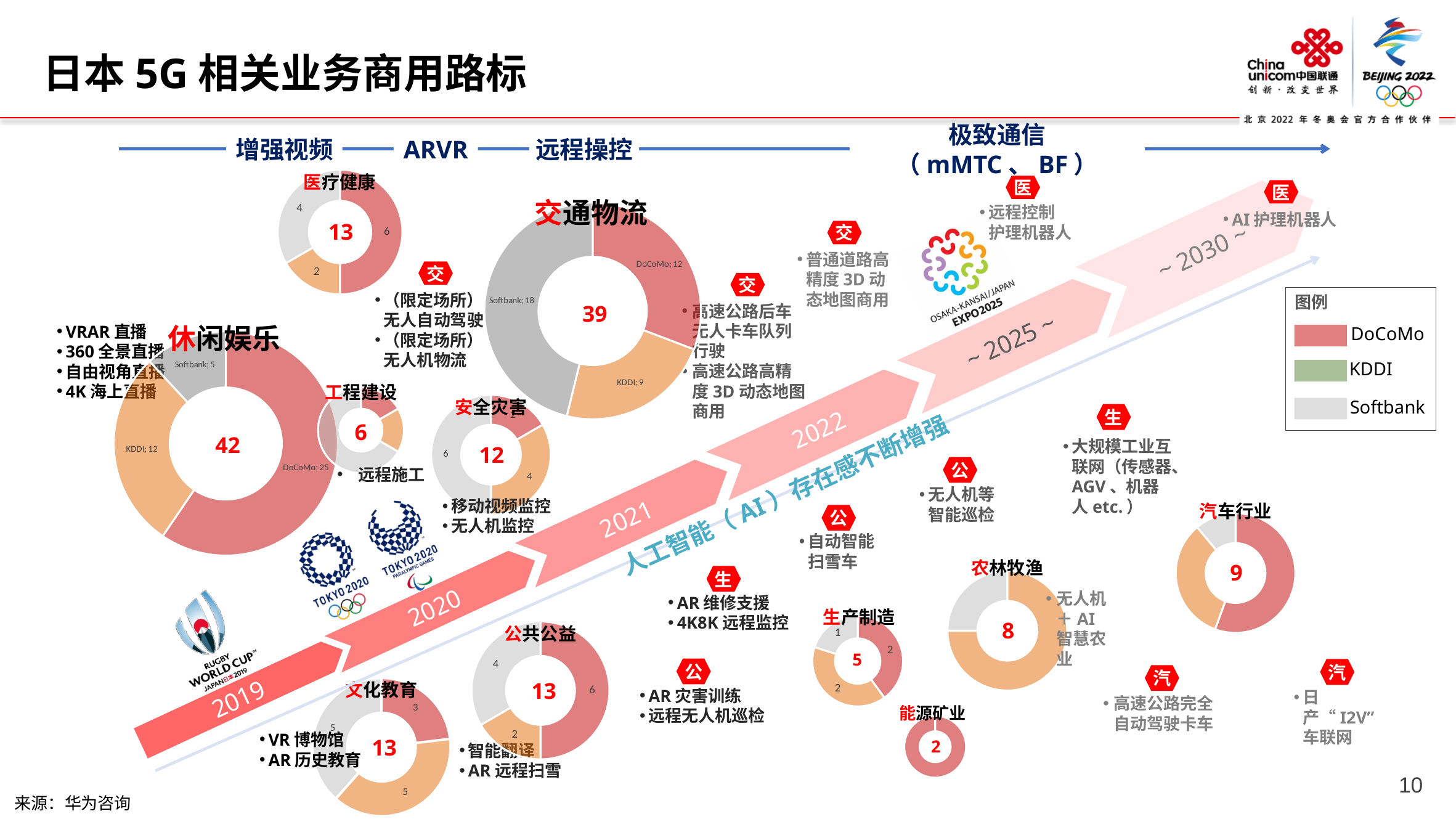
In the 休闲娱乐 chart, what is the value for DoCoMo? 25 In the 交通物流 chart, which operator has the smallest value? KDDI In the 交通物流 chart, which operator has the largest value? Softbank What kind of chart is used for each industry on the slide? Donut (pie) chart In the 休闲娱乐 chart, which operator has the largest value? DoCoMo How many operators does the legend (图例) list? 3 Which chart on the slide has the smallest centre total? 能源矿业 In the 交通物流 chart, what is the difference between the Softbank value and the DoCoMo value? 6 What is the number shown in the centre of the 汽车行业 chart? 9 What is the total shown in the centre of the 交通物流 chart? 39 Which has the larger centre total, the 休闲娱乐 chart or the 交通物流 chart? 休闲娱乐 In the 交通物流 chart, what is the value for DoCoMo? 12